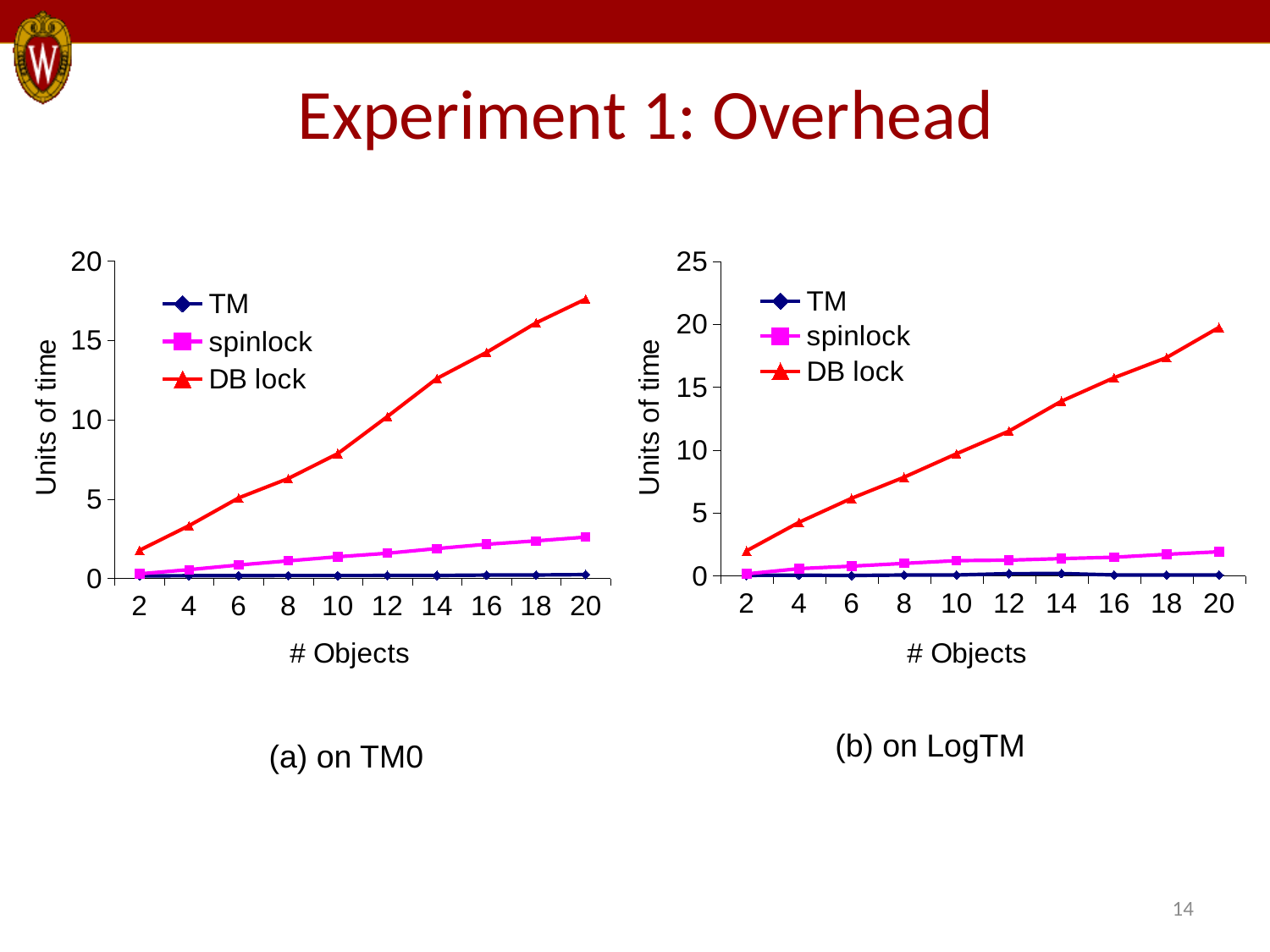
In the chart captioned "(b) on LogTM", is the DB lock value at 8 objects greater or less than 10? less In the chart captioned "(b) on LogTM", does the DB lock series rise or fall as # Objects increases? rise In the chart captioned "(a) on TM0", is the DB lock value at 20 objects greater or less than 15? greater How many series does the legend list in the chart captioned "(b) on LogTM"? 3 What kind of chart is the chart captioned "(a) on TM0"? line chart In the chart captioned "(a) on TM0", at 14 objects, which is larger: the DB lock value or the spinlock value? DB lock In the chart captioned "(a) on TM0", which series has the highest values across the x axis? DB lock In the chart captioned "(b) on LogTM", is the DB lock value at 20 objects greater or less than 15? greater What is the y-axis title of the chart captioned "(b) on LogTM"? Units of time In the chart captioned "(b) on LogTM", which series has the lowest values across the x axis? TM How many # Objects values are plotted along the x axis of the chart captioned "(a) on TM0"? 10